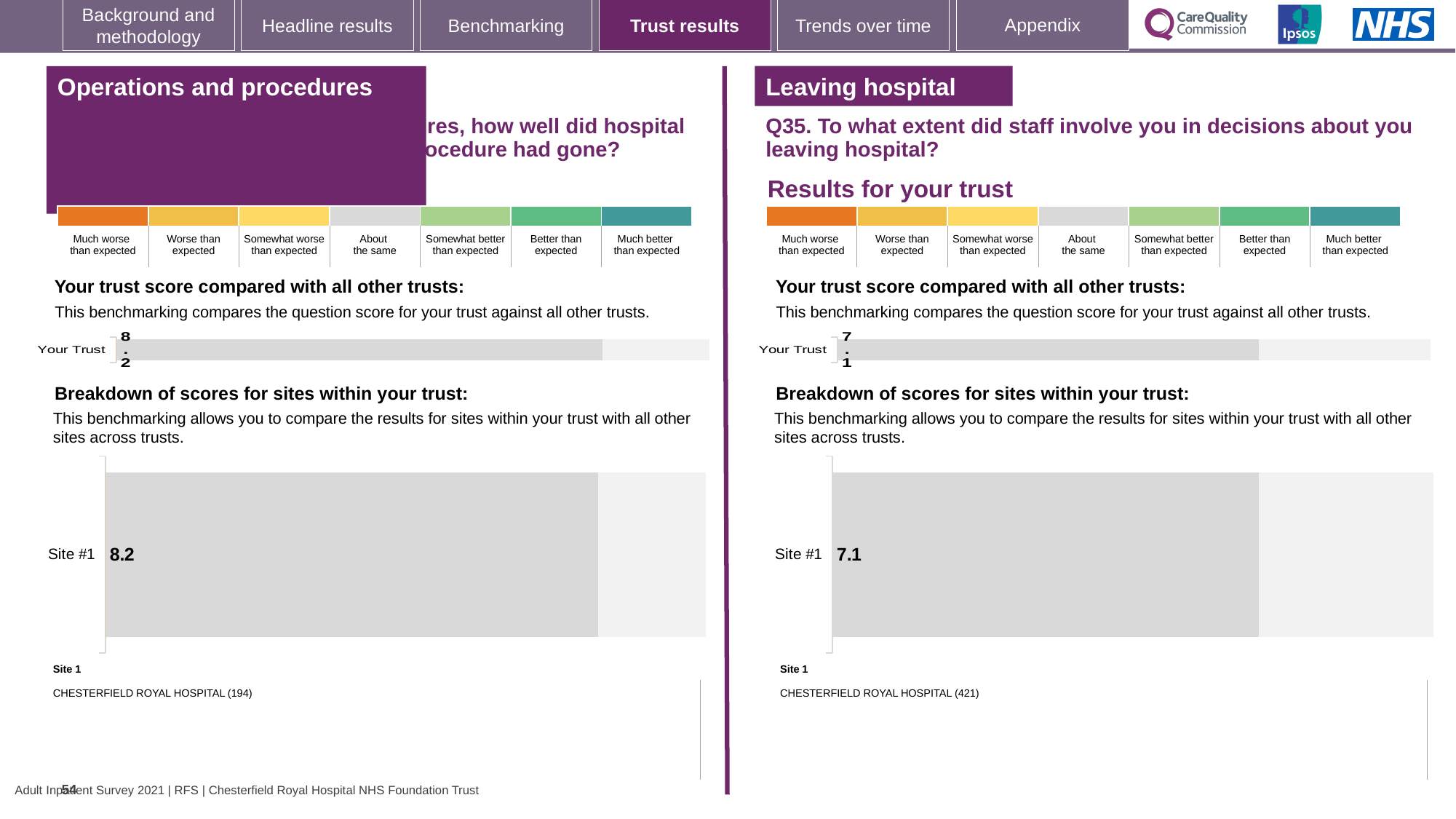
Which question is the right-hand 'Leaving hospital' chart about? Q35. To what extent did staff involve you in decisions about you leaving hospital? On the left-hand 'Operations and procedures' section, what is the score shown for Your Trust in the 'Your trust score compared with all other trusts' chart? 8.2 Which is larger: the Your Trust score in the left-hand 'Operations and procedures' chart or the Your Trust score in the right-hand 'Leaving hospital' chart? Operations and procedures (8.2) What type of chart is used to show the Site #1 score in the 'Breakdown of scores for sites within your trust' section on the left-hand side? Bar chart What is the difference between the Site #1 score in the left-hand 'Operations and procedures' breakdown chart and the Site #1 score in the right-hand 'Leaving hospital' breakdown chart? 1.1 How many categories are plotted in the 'Your trust score compared with all other trusts' chart on the left-hand side of the slide? 1 In the 'Breakdown of scores for sites within your trust' chart on the left-hand side of the slide, what is the score for Site #1? 8.2 On the right-hand 'Leaving hospital' section, what is the score shown for Your Trust in the 'Your trust score compared with all other trusts' chart? 7.1 How many sites are plotted in the 'Breakdown of scores for sites within your trust' chart on the right-hand side of the slide? 1 Which site name is listed under 'Site 1' beneath the right-hand 'Leaving hospital' breakdown chart? CHESTERFIELD ROYAL HOSPITAL (421) In the 'Breakdown of scores for sites within your trust' chart on the right-hand side of the slide, what is the score for Site #1? 7.1